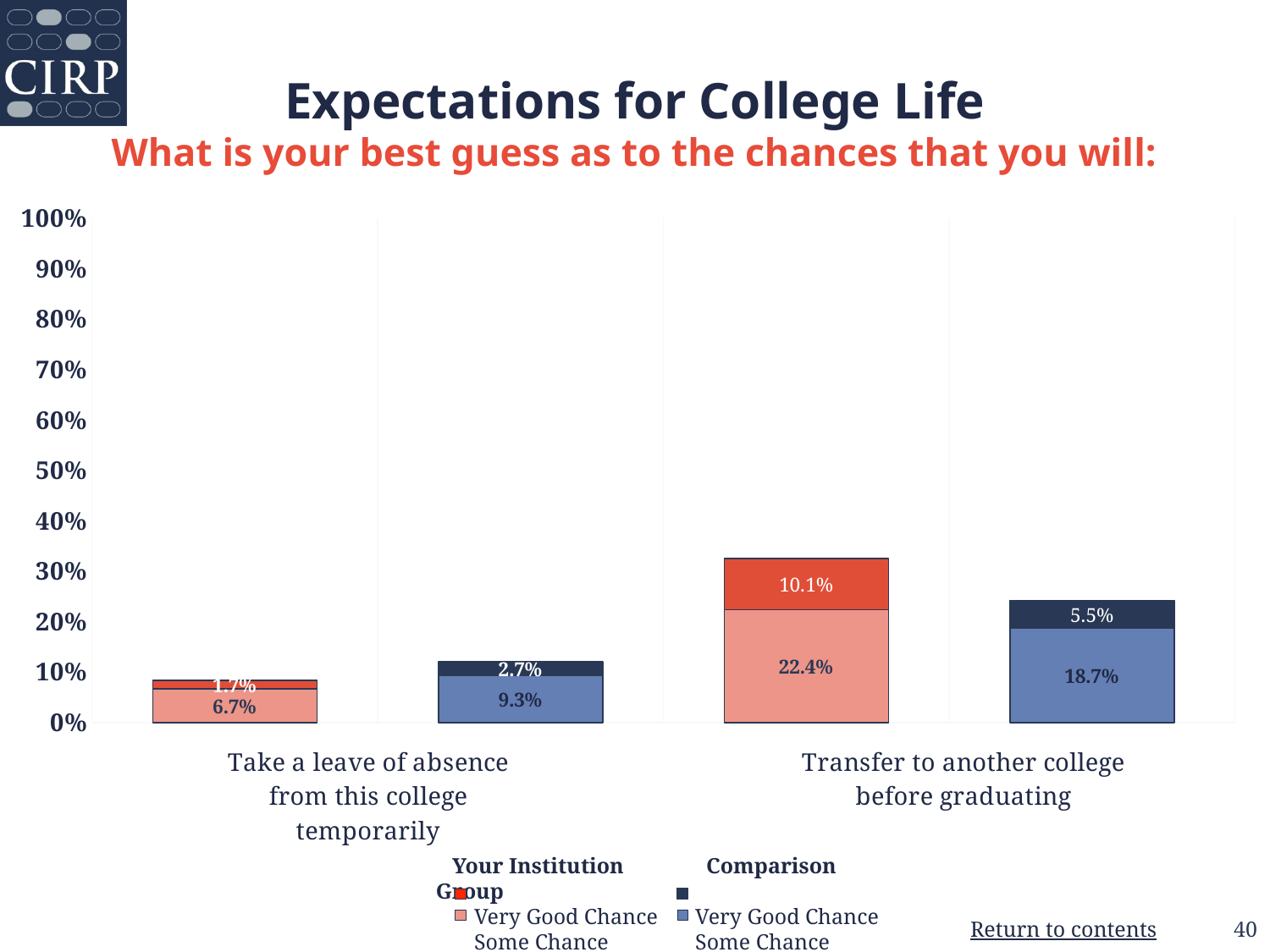
What is the 'Very Good Chance' value for Your Institution for 'Take a leave of absence from this college temporarily'? 1.7% Which stacked bar is the tallest on the chart? Your Institution, Transfer to another college before graduating What is the 'Some Chance' value for the Comparison Group for 'Transfer to another college before graduating'? 18.7% Is the total of the Comparison Group bar for 'Transfer to another college before graduating' greater or less than 20%? greater What kind of chart is shown on the slide? Stacked bar chart What is the 'Very Good Chance' value for the Comparison Group for 'Take a leave of absence from this college temporarily'? 2.7% What is the total of the stacked bar for Your Institution for 'Transfer to another college before graduating'? 32.5% What is the difference between the 'Some Chance' values for Your Institution and the Comparison Group for 'Transfer to another college before graduating'? 3.7% Which is larger for 'Transfer to another college before graduating': the 'Very Good Chance' value for Your Institution or for the Comparison Group? Your Institution How many series does the legend list? 4 What is the 'Some Chance' value for Your Institution for 'Transfer to another college before graduating'? 22.4% What is the total of the stacked bar for the Comparison Group for 'Take a leave of absence from this college temporarily'? 12.0%